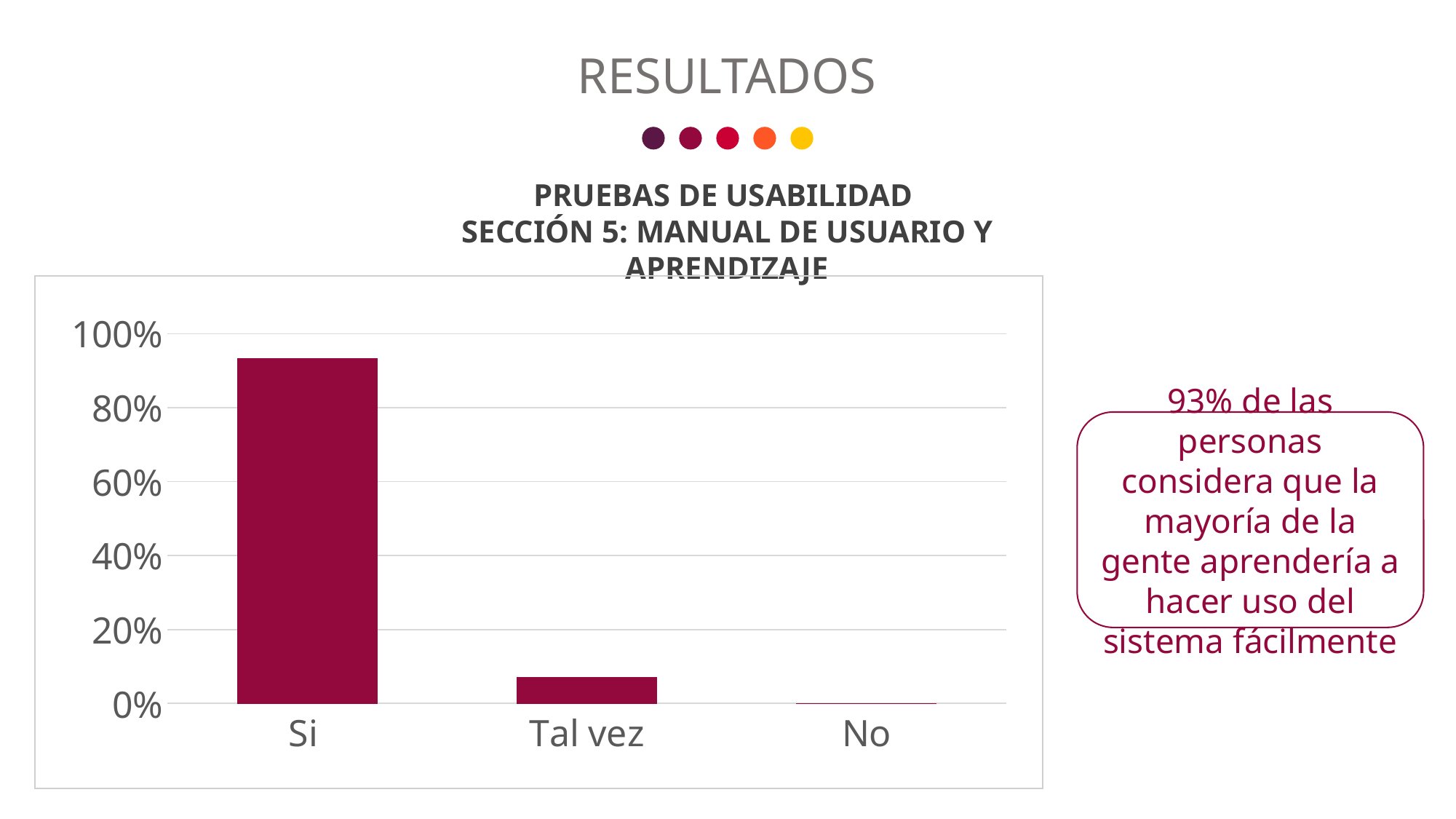
Which category has the highest bar in the chart? Si What is the title of the chart? PRUEBAS DE USABILIDAD SECCIÓN 5: MANUAL DE USUARIO Y APRENDIZAJE Is the value for Si greater or less than 80%? greater How many categories are shown on the x axis of the chart? 3 Is the value for Tal vez greater or less than 20%? less What kind of chart is shown on the slide? bar chart Which is larger, the value for Si or the value for Tal vez? Si Do the bar values rise or fall from left to right across the x axis? fall Is the value for Si greater or less than 100%? less What is the highest value shown on the y axis of the chart? 100% Which category has the lowest bar in the chart? No